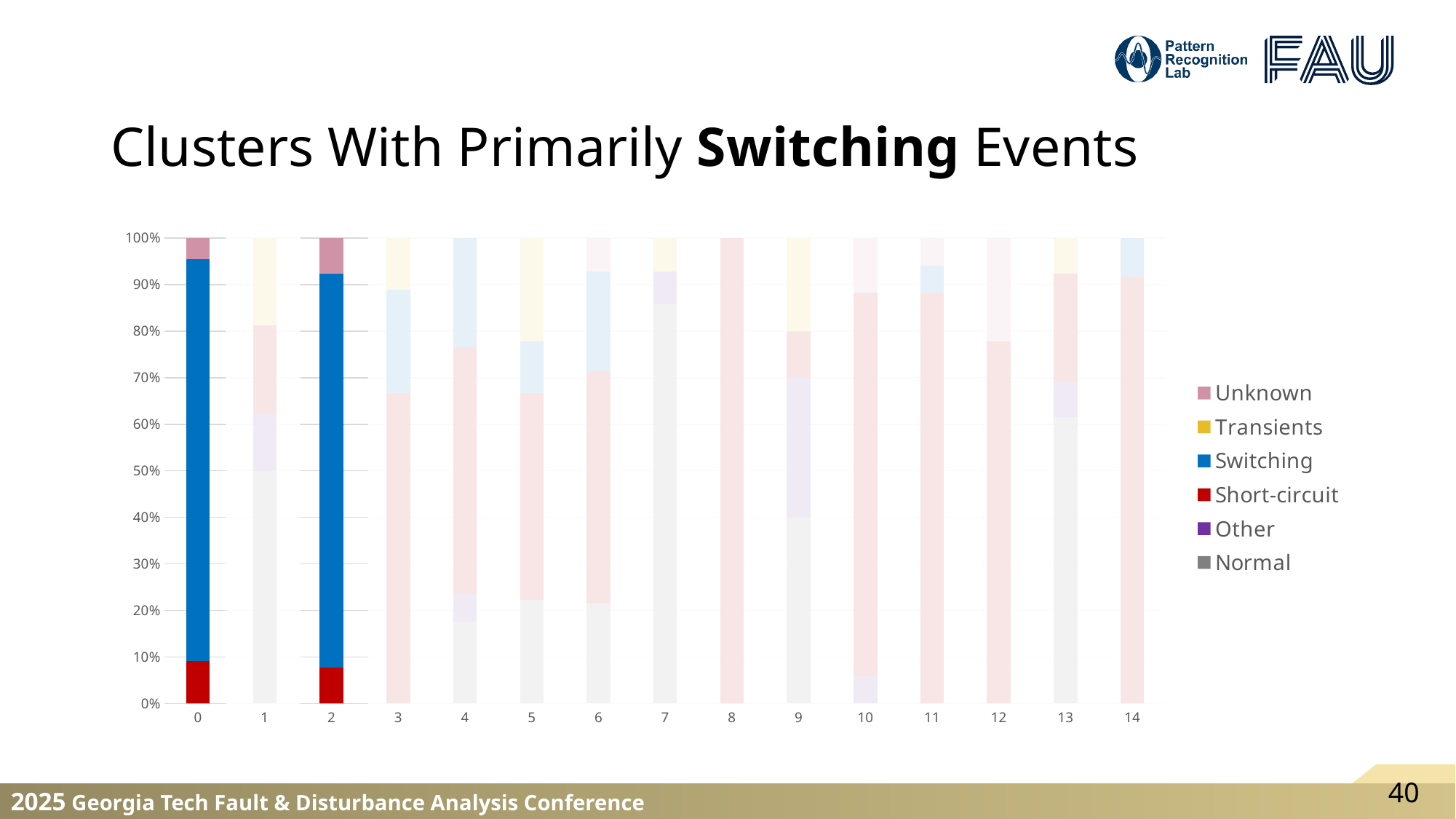
Is the Short-circuit share for cluster 0 greater or less than 10%? less What is the total height of each stacked bar in the chart? 100% What kind of chart is shown on the slide? Stacked bar chart How many clusters (categories) are shown along the x axis? 15 Which clusters are highlighted (drawn in full colour) in the chart? 0 and 2 Is the Short-circuit share for cluster 2 greater or less than 10%? less Which series makes up the largest share of the bar for cluster 0? Switching Is the top of the Switching segment for cluster 0 greater or less than 90%? greater What is the title of the slide containing the chart? Clusters With Primarily Switching Events How many series does the legend list? 6 Which cluster has the larger Unknown share, cluster 0 or cluster 2? Cluster 2